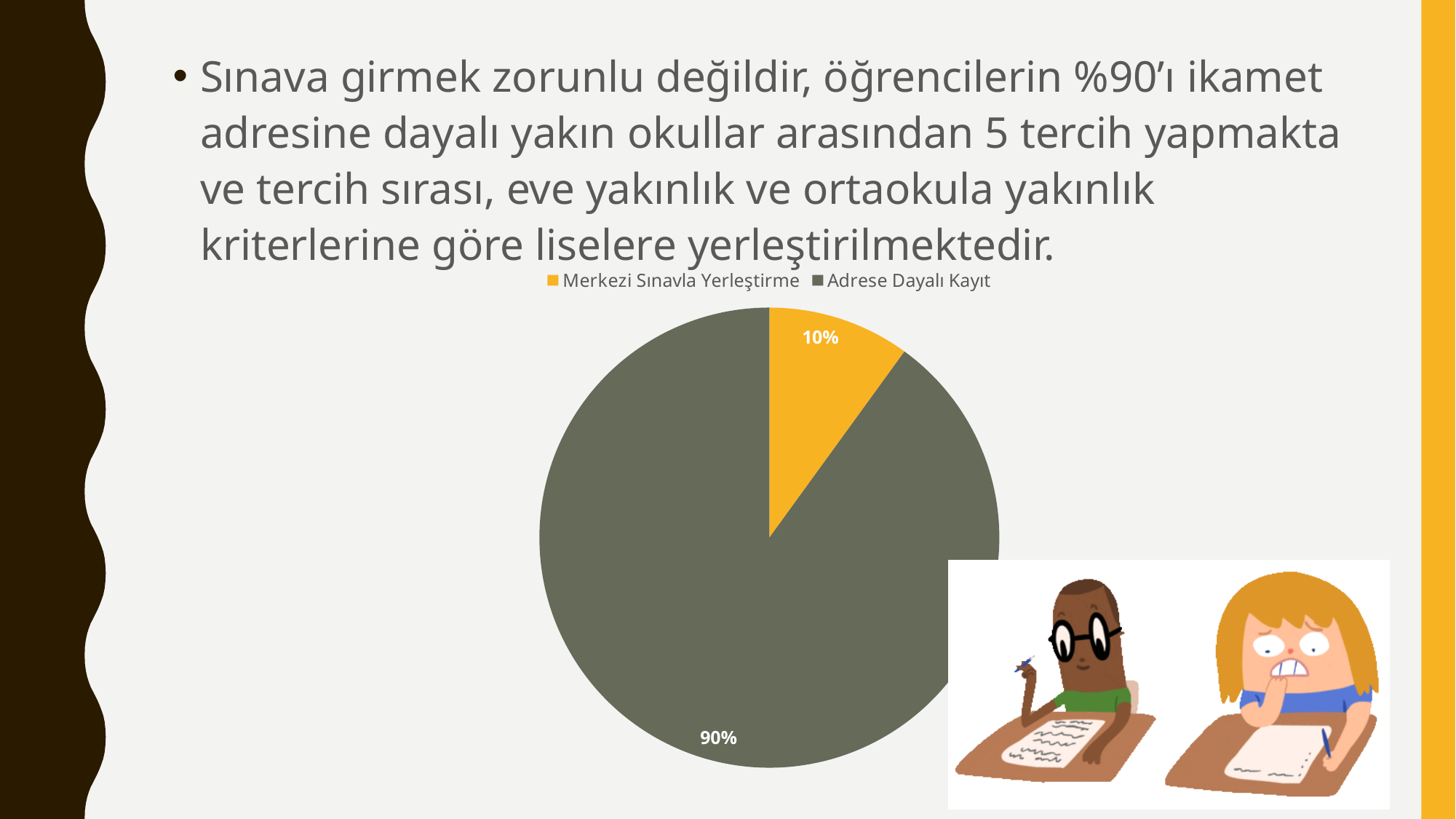
Which slice of the pie chart is the smallest? Merkezi Sınavla Yerleştirme How many entries does the legend list? 2 What kind of chart is shown on the slide? Pie chart What percentage is shown for Merkezi Sınavla Yerleştirme? 10% What percentage is shown for Adrese Dayalı Kayıt? 90% What share of the pie does Merkezi Sınavla Yerleştirme represent? 10% Which is larger, Merkezi Sınavla Yerleştirme or Adrese Dayalı Kayıt? Adrese Dayalı Kayıt What colour is the Merkezi Sınavla Yerleştirme slice? Yellow/orange What is the difference between the Adrese Dayalı Kayıt and Merkezi Sınavla Yerleştirme percentages? 80% How many slices does the pie chart have? 2 Which slice of the pie chart is the largest? Adrese Dayalı Kayıt What is the total of the two slices shown in the pie chart? 100%